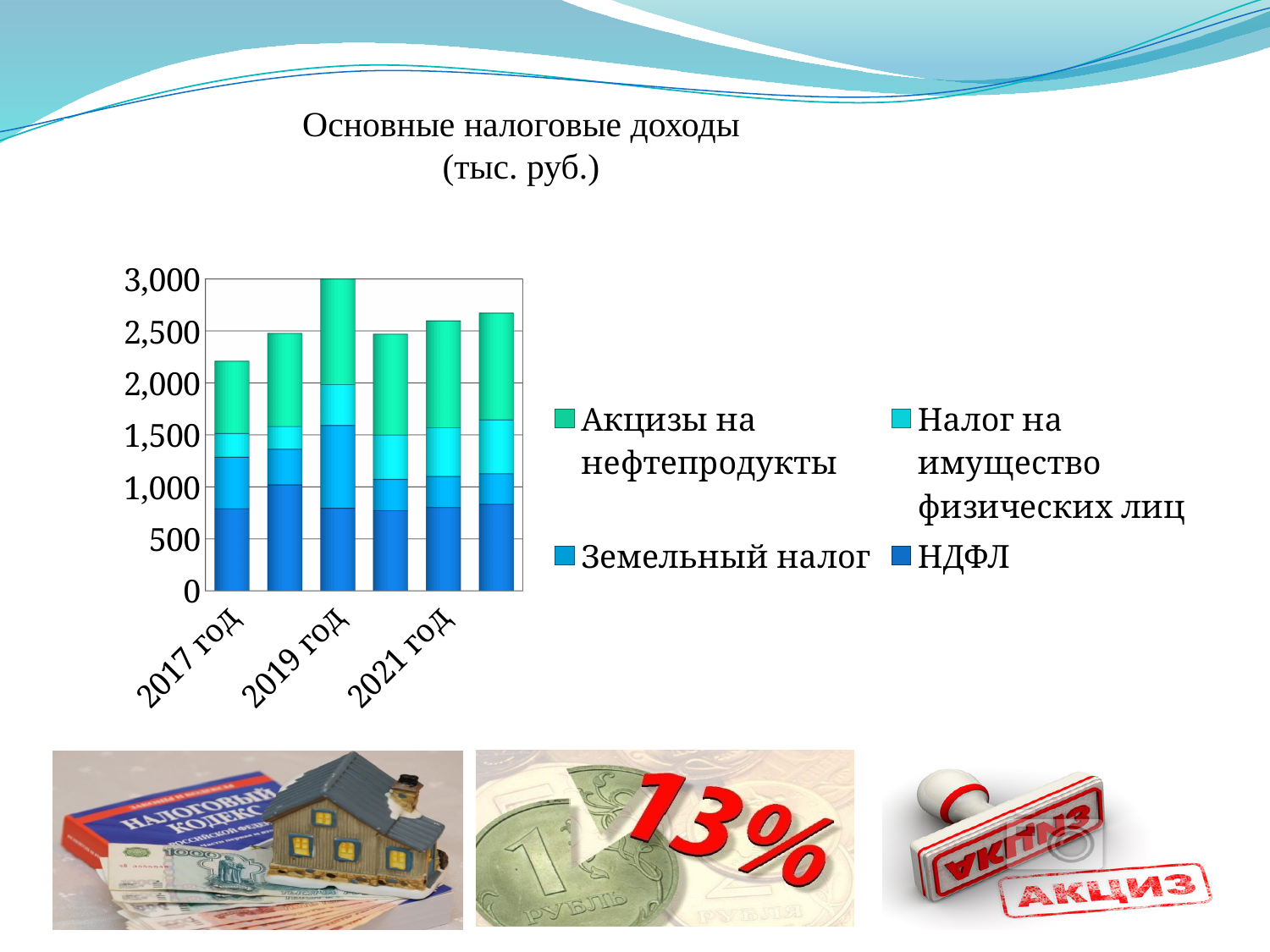
Is the total for 2017 год greater or less than 2,000? greater Which series is shown in the darkest blue at the bottom of each bar? НДФЛ What is the title of the chart? Основные налоговые доходы (тыс. руб.) Is the total for 2021 год greater or less than 2,000? greater Is the НДФЛ value for 2017 год greater or less than 1,000? less Which is larger, the total for 2017 год or the total for 2019 год? 2019 год Which year has the tallest stacked bar? 2019 год What kind of chart is shown on the slide? stacked bar chart How many bars are plotted in the chart? 6 Which year has the shortest stacked bar? 2017 год How many series does the legend list? 4